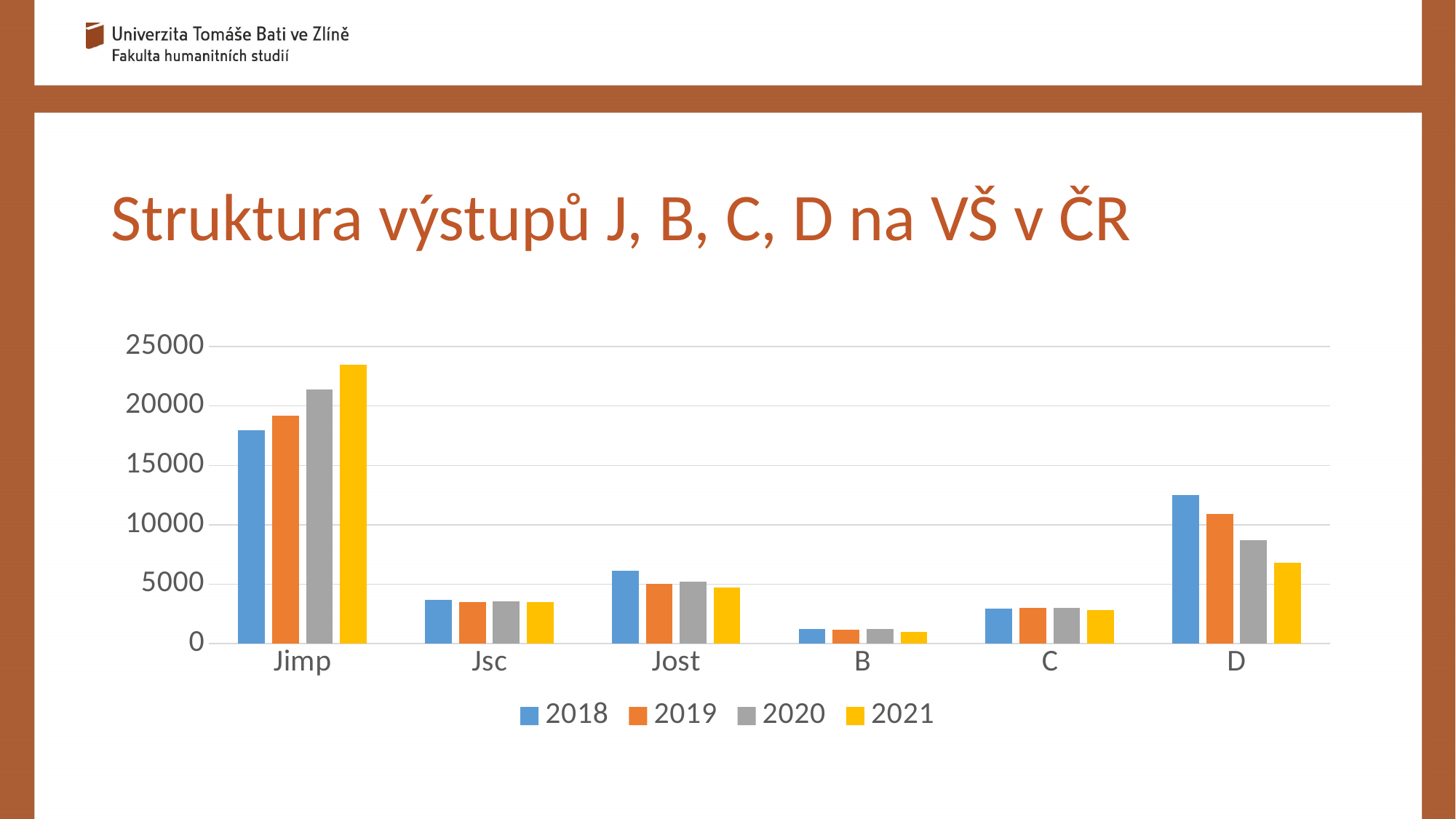
How many categories are shown on the x axis? 6 What is the title of the slide containing the chart? Struktura výstupů J, B, C, D na VŠ v ČR Is the value for D in 2018 greater or less than 10000? greater What kind of chart is shown on the slide? bar chart Is the value for Jimp in 2021 greater or less than 20000? greater How many series does the legend list? 4 Which category has the lowest value for 2018? B Which category has the highest value for 2021? Jimp For the D category, do the values rise or fall from 2018 to 2021? fall Is the value for D in 2021 greater or less than 10000? less Which is larger, the 2018 value for Jost or the 2018 value for Jsc? Jost For the Jimp category, do the values rise or fall from 2018 to 2021? rise